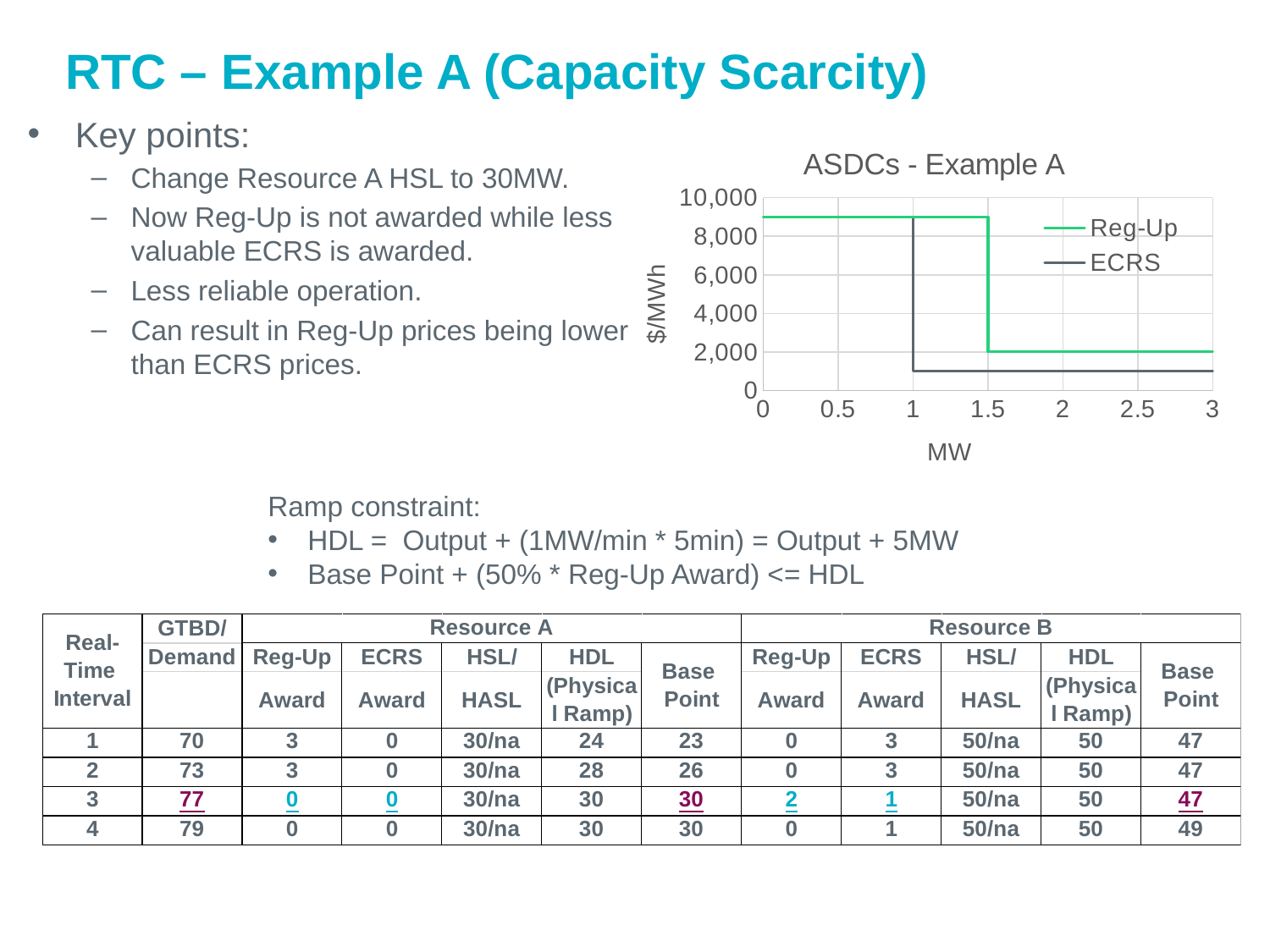
How many series does the legend of the 'ASDCs - Example A' chart list? 2 In the 'ASDCs - Example A' chart, which series has the higher value at 2 MW, Reg-Up or ECRS? Reg-Up What kind of chart is 'ASDCs - Example A'? line chart In the 'ASDCs - Example A' chart, is the Reg-Up value at 0.5 MW greater or less than 8,000? greater In the 'ASDCs - Example A' chart, is the Reg-Up value at 2 MW greater or less than 4,000? less In the 'ASDCs - Example A' chart, is the ECRS value at 0.5 MW greater or less than 6,000? greater What is the y-axis label on the 'ASDCs - Example A' chart? $/MWh In the 'ASDCs - Example A' chart, which series drops from its high level first as MW increases, Reg-Up or ECRS? ECRS In the 'ASDCs - Example A' chart, do the Reg-Up values rise or fall as MW increases? fall What are the two series named in the legend of the 'ASDCs - Example A' chart? Reg-Up and ECRS In the 'ASDCs - Example A' chart, which series has the higher value at 1.25 MW, Reg-Up or ECRS? Reg-Up